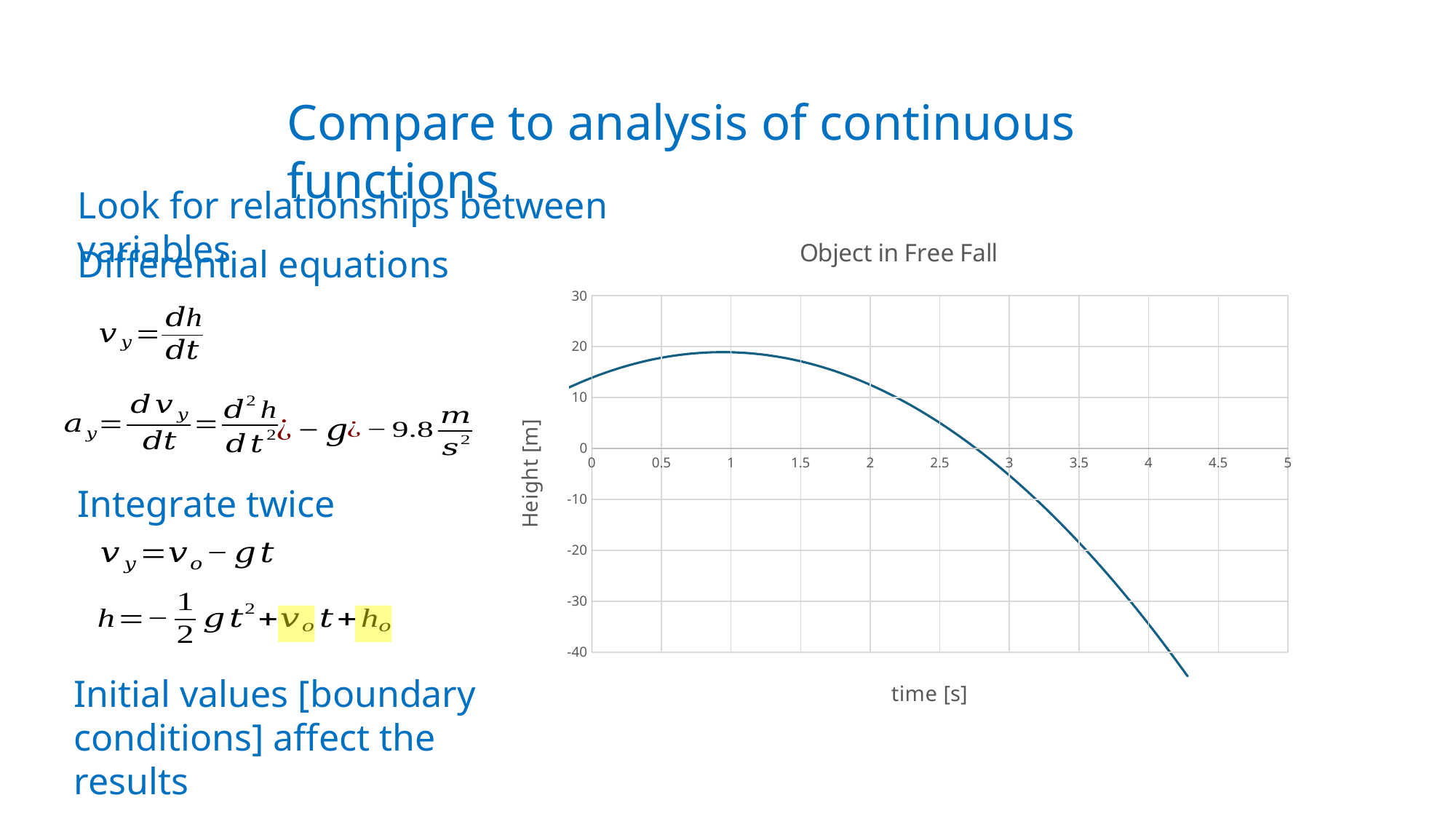
Does the height rise or fall as time increases from 0 s to 1 s? rise Which is larger, the height at time 0 s or the height at time 4 s? time 0 s Is the height at time 0 s greater or less than 10 m? greater What is the label of the vertical axis of the chart? Height [m] What is the title of the chart? Object in Free Fall What kind of chart is shown on the slide? line chart Is the height at time 2 s greater or less than 0 m? greater Which is larger, the height at time 1 s or the height at time 3 s? time 1 s Is the height at time 3 s greater or less than 0 m? less Does the height rise or fall as time increases from 1 s to 4 s? fall